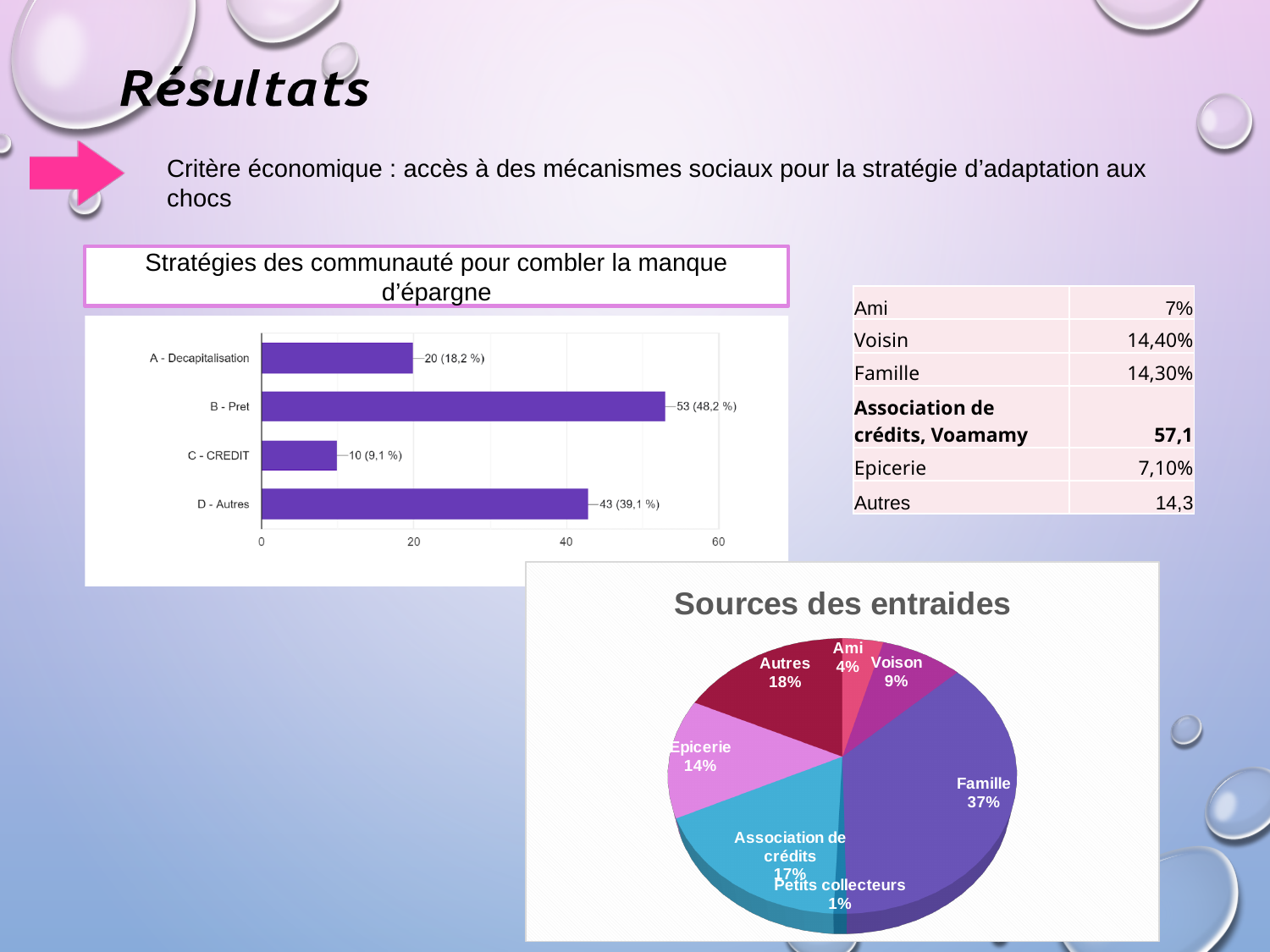
In the pie chart 'Sources des entraides', which is larger, Epicerie or Autres? Autres In the pie chart 'Sources des entraides', what share does Association de crédits have? 17% In the bar chart 'Stratégies des communauté pour combler la manque d'épargne', what is the value for B - Pret? 53 (48,2 %) In the bar chart 'Stratégies des communauté pour combler la manque d'épargne', which category has the lowest value? C - CREDIT In the bar chart 'Stratégies des communauté pour combler la manque d'épargne', what is the value for C - CREDIT? 10 (9,1 %) How many slices does the pie chart 'Sources des entraides' have? 7 In the bar chart 'Stratégies des communauté pour combler la manque d'épargne', which category has the highest value? B - Pret In the bar chart 'Stratégies des communauté pour combler la manque d'épargne', how many categories are shown? 4 In the pie chart 'Sources des entraides', what share does Famille have? 37% What type of chart is 'Stratégies des communauté pour combler la manque d'épargne'? Bar chart In the bar chart 'Stratégies des communauté pour combler la manque d'épargne', what is the difference between the counts for B - Pret and D - Autres? 10 In the pie chart 'Sources des entraides', which slice is the smallest? Petits collecteurs